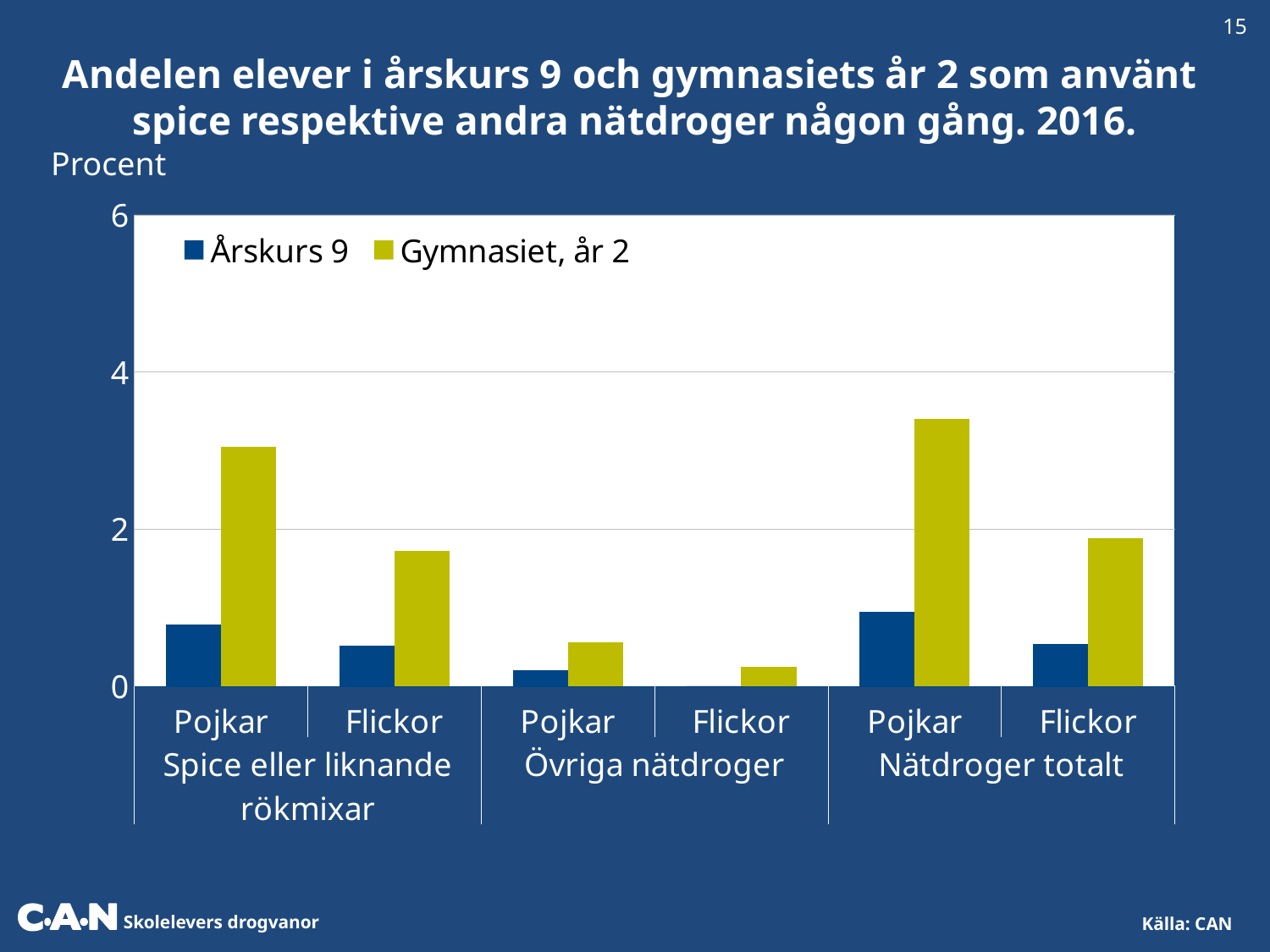
How many Pojkar/Flickor categories are shown along the x axis in total? 6 Which category has the highest bar for Gymnasiet, år 2? Pojkar, Nätdroger totalt What are the two series named in the legend? Årskurs 9 and Gymnasiet, år 2 What kind of chart is shown on the slide? Bar chart Is the value for Gymnasiet, år 2 Pojkar under Spice eller liknande rökmixar greater or less than 2? greater Within Spice eller liknande rökmixar, which is larger for Gymnasiet, år 2: Pojkar or Flickor? Pojkar How many series does the legend list? 2 How many main drug categories are shown along the x axis? 3 Which series has the taller bars in every category, Årskurs 9 or Gymnasiet, år 2? Gymnasiet, år 2 Is the value for Gymnasiet, år 2 Flickor under Spice eller liknande rökmixar greater or less than 2? less Is the value for Årskurs 9 Pojkar under Nätdroger totalt greater or less than 2? less